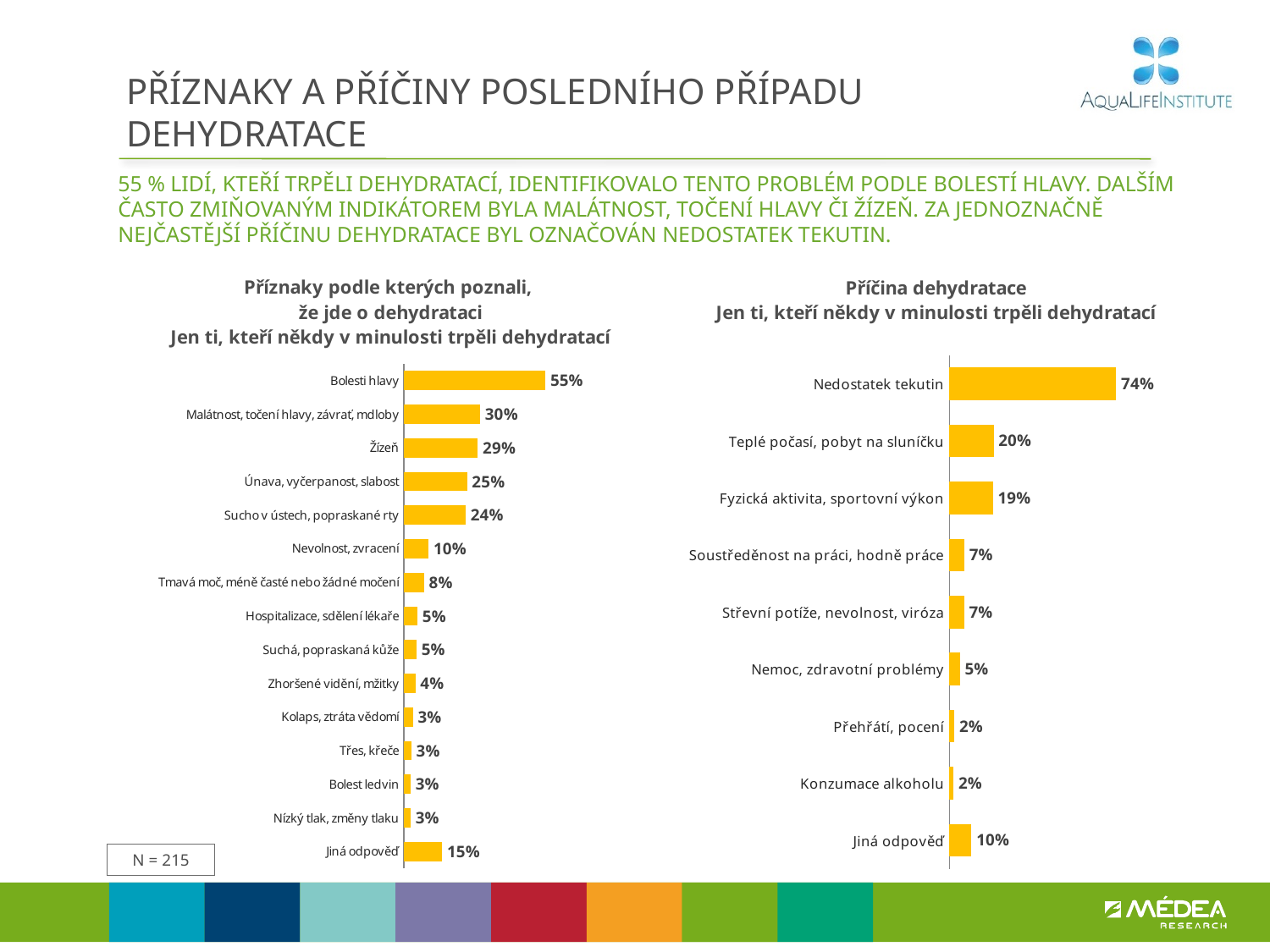
In the left chart (Příznaky podle kterých poznali, že jde o dehydrataci), which is larger: Nevolnost, zvracení or Jiná odpověď? Jiná odpověď In the right chart (Příčina dehydratace), what is the difference between Nedostatek tekutin and Teplé počasí, pobyt na sluníčku? 54% In the right chart (Příčina dehydratace), what is the value for Teplé počasí, pobyt na sluníčku? 20% How many categories are shown in the left chart (Příznaky podle kterých poznali, že jde o dehydrataci)? 15 In the left chart (Příznaky podle kterých poznali, že jde o dehydrataci), what is the value for Bolesti hlavy? 55% What type of chart is the right chart (Příčina dehydratace)? Bar chart In the left chart (Příznaky podle kterých poznali, že jde o dehydrataci), which category has the highest value? Bolesti hlavy In the right chart (Příčina dehydratace), which is larger: Nemoc, zdravotní problémy or Jiná odpověď? Jiná odpověď In the left chart (Příznaky podle kterých poznali, že jde o dehydrataci), what is the value for Sucho v ústech, popraskané rty? 24% In the right chart (Příčina dehydratace), which category has the highest value? Nedostatek tekutin How many categories are shown in the right chart (Příčina dehydratace)? 9 In the left chart (Příznaky podle kterých poznali, že jde o dehydrataci), what is the difference between Bolesti hlavy and Malátnost, točení hlavy, závrať, mdloby? 25%